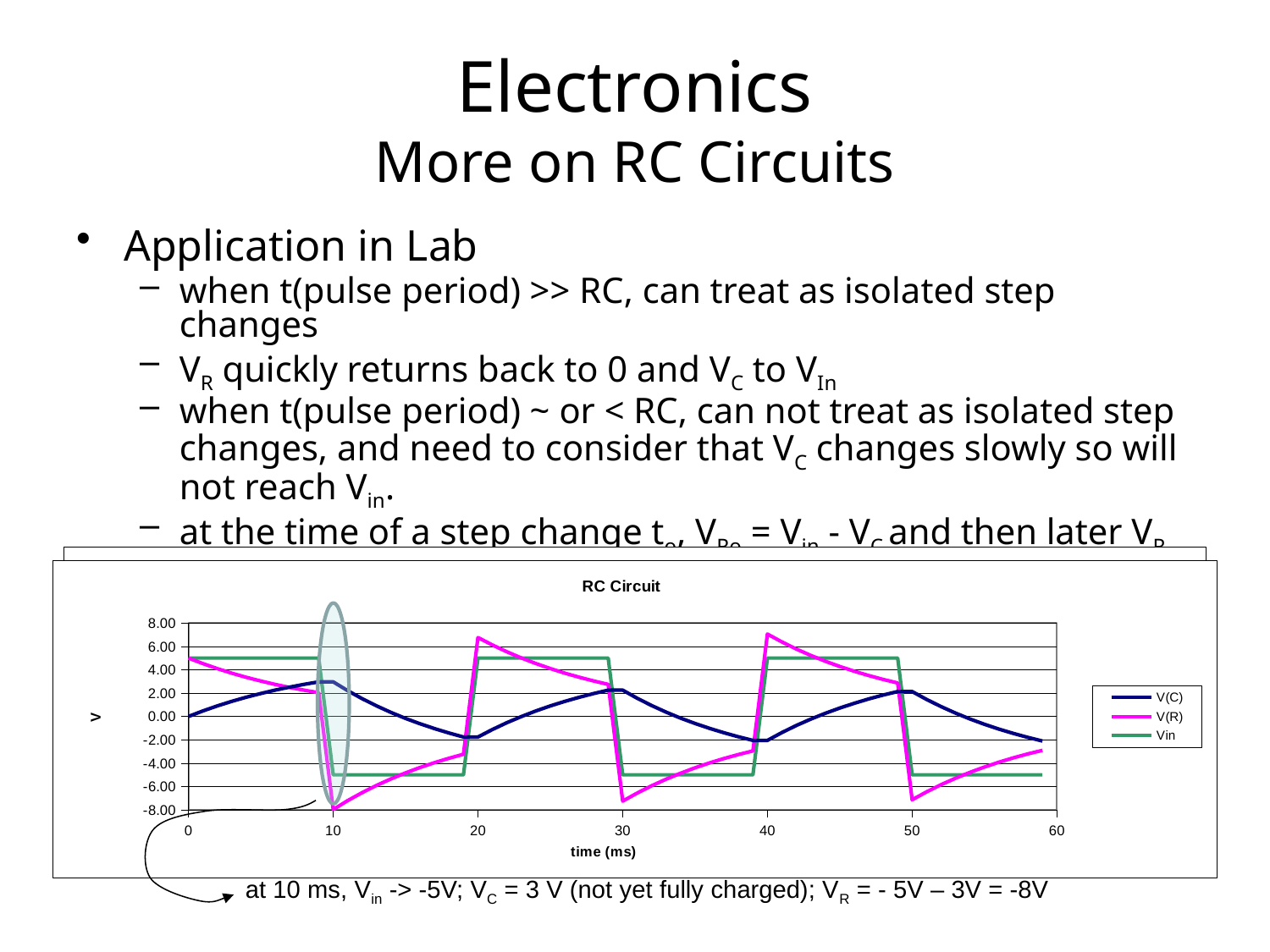
At 10 ms, which is larger, V(C) or V(R)? V(C) Is the value of V(C) at 30 ms greater or less than 4.00? less According to the annotation, what is the value of V(C) at 10 ms? 3 V What is the title of the chart? RC Circuit Is the value of V(R) at 20 ms greater or less than 6.00? greater Which series reaches the highest value on the chart? V(R) According to the annotation, what is the value of V(R) at 10 ms? -8V According to the annotation, what value does Vin step to at 10 ms? -5V Does V(C) rise or fall between 0 and 10 ms? rise What type of chart is shown on the slide? line chart What is the label of the x axis of the chart? time (ms) How many series does the legend of the RC Circuit chart list? 3